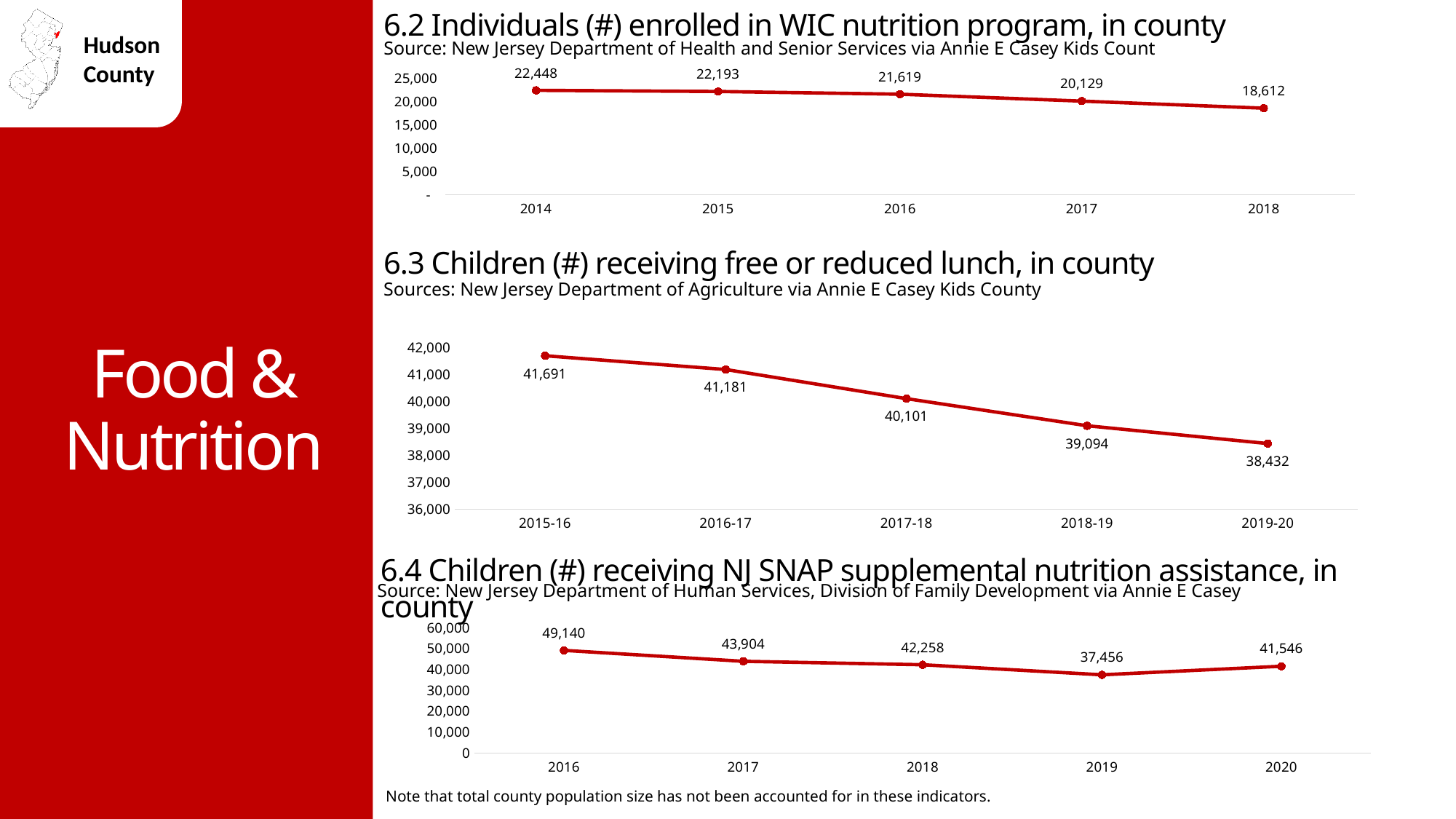
In the chart '6.2 Individuals (#) enrolled in WIC nutrition program, in county', what is the value for 2016? 21,619 In the chart '6.3 Children (#) receiving free or reduced lunch, in county', which school year has the highest value? 2015-16 In the chart '6.2 Individuals (#) enrolled in WIC nutrition program, in county', what is the difference between the 2014 and 2018 values? 3,836 In the chart '6.4 Children (#) receiving NJ SNAP supplemental nutrition assistance, in county', which year has the highest value? 2016 In the chart '6.4 Children (#) receiving NJ SNAP supplemental nutrition assistance, in county', what is the value for 2019? 37,456 In the chart '6.2 Individuals (#) enrolled in WIC nutrition program, in county', do the values rise or fall from 2014 to 2018? fall In the chart '6.3 Children (#) receiving free or reduced lunch, in county', what is the value for 2017-18? 40,101 In the chart '6.3 Children (#) receiving free or reduced lunch, in county', how many data points are plotted? 5 In the chart '6.2 Individuals (#) enrolled in WIC nutrition program, in county', which year has the lowest value? 2018 In the chart '6.4 Children (#) receiving NJ SNAP supplemental nutrition assistance, in county', which is larger, the value for 2018 or the value for 2020? 2018 In the chart '6.4 Children (#) receiving NJ SNAP supplemental nutrition assistance, in county', what is the difference between the 2016 and 2017 values? 5,236 What kind of chart is '6.3 Children (#) receiving free or reduced lunch, in county'? line chart